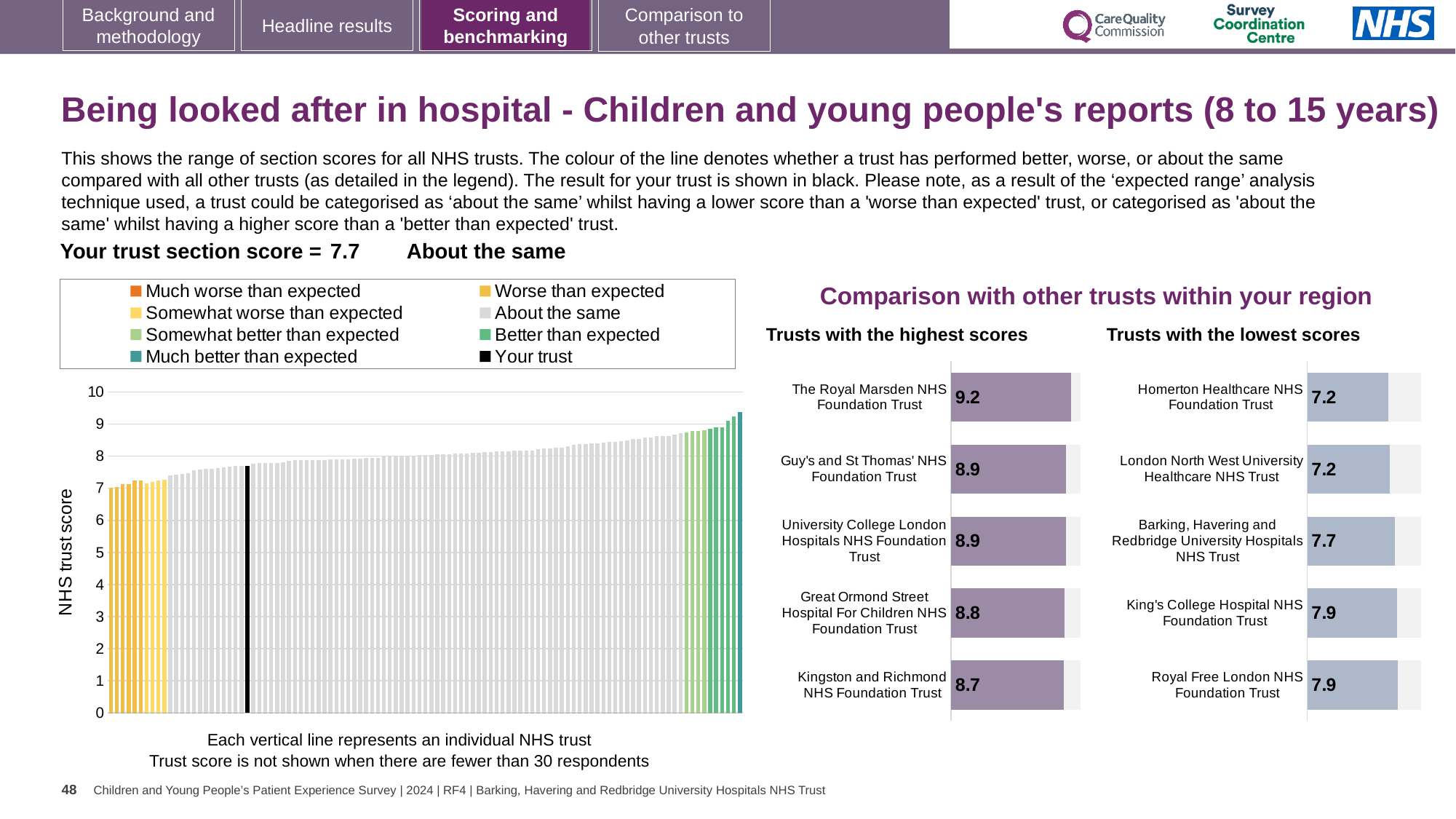
In the 'Trusts with the lowest scores' chart, what is the score for Barking, Havering and Redbridge University Hospitals NHS Trust? 7.7 In the large chart on the left, do the bar heights rise or fall from left to right? Rise In the 'Trusts with the highest scores' chart, what is the score for Kingston and Richmond NHS Foundation Trust? 8.7 What kind of chart is the large chart on the left showing NHS trust scores? Bar chart How many trusts are shown in the 'Trusts with the lowest scores' chart? 5 How many entries does the legend of the large chart on the left list? 8 In the 'Trusts with the highest scores' chart, what is the difference between the scores of The Royal Marsden NHS Foundation Trust and Kingston and Richmond NHS Foundation Trust? 0.5 In the 'Trusts with the lowest scores' chart, what is the score for Homerton Healthcare NHS Foundation Trust? 7.2 In the 'Trusts with the lowest scores' chart, which has the larger score: Barking, Havering and Redbridge University Hospitals NHS Trust or King's College Hospital NHS Foundation Trust? King's College Hospital NHS Foundation Trust In the large chart on the left, is the value of the black 'Your trust' bar greater or less than 8? less In the 'Trusts with the highest scores' chart, which trust has the highest score? The Royal Marsden NHS Foundation Trust In the 'Trusts with the highest scores' chart, what is the score for The Royal Marsden NHS Foundation Trust? 9.2